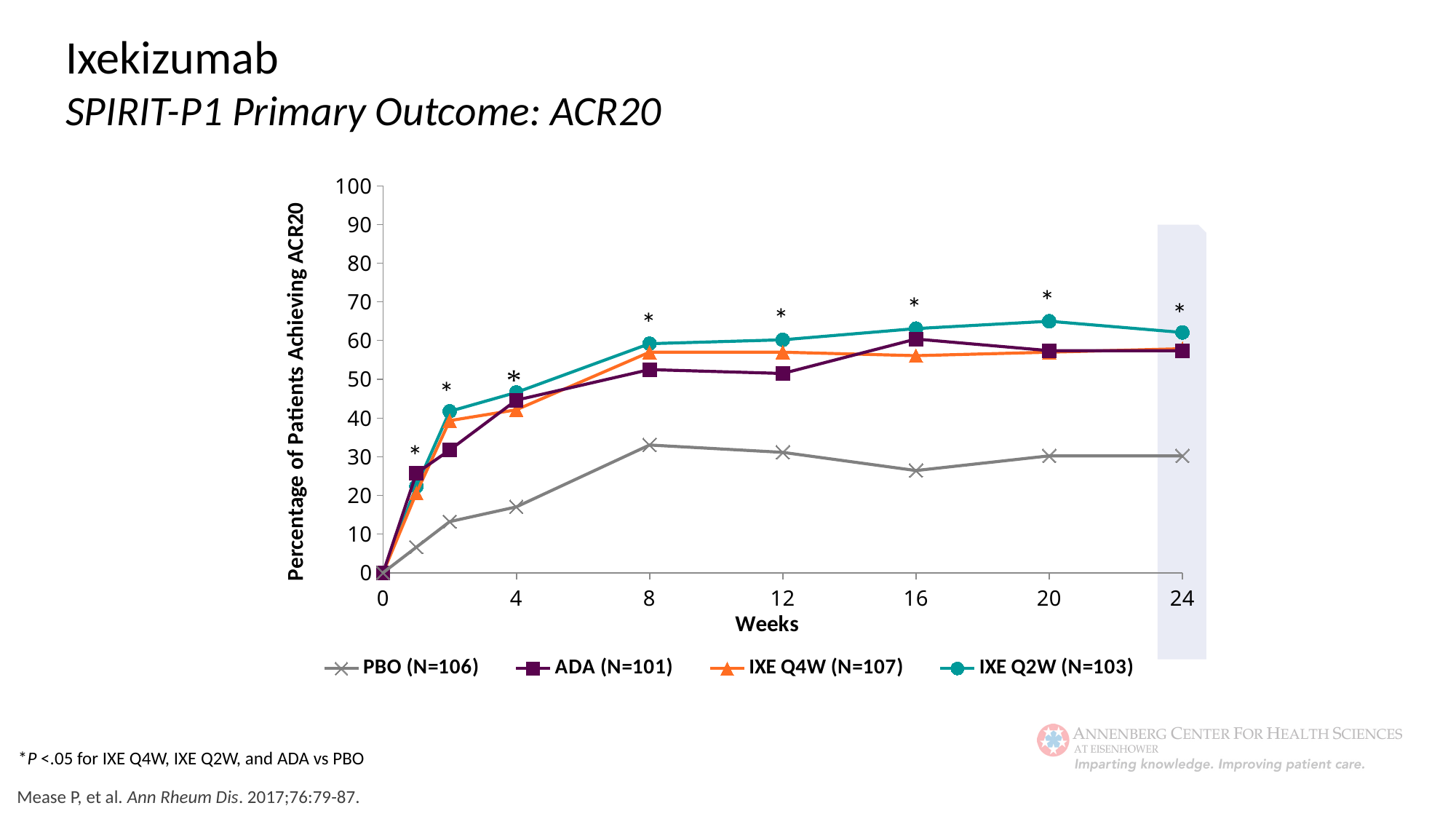
Is the value for PBO at week 8 greater or less than 20? greater Is the value for IXE Q2W at week 2 greater or less than 30? greater What is the label of the x axis? Weeks How many series does the legend list? 4 Is the value for PBO at week 24 greater or less than 40? less What kind of chart is shown on the slide? line chart Which series has the lowest percentage of patients achieving ACR20 at week 24? PBO (N=106) Which series has the highest percentage of patients achieving ACR20 at week 20? IXE Q2W (N=103) Does the PBO line rise or fall between week 0 and week 8? rise What is the label of the y axis? Percentage of Patients Achieving ACR20 At week 24, which is larger: the value for IXE Q2W or the value for PBO? IXE Q2W